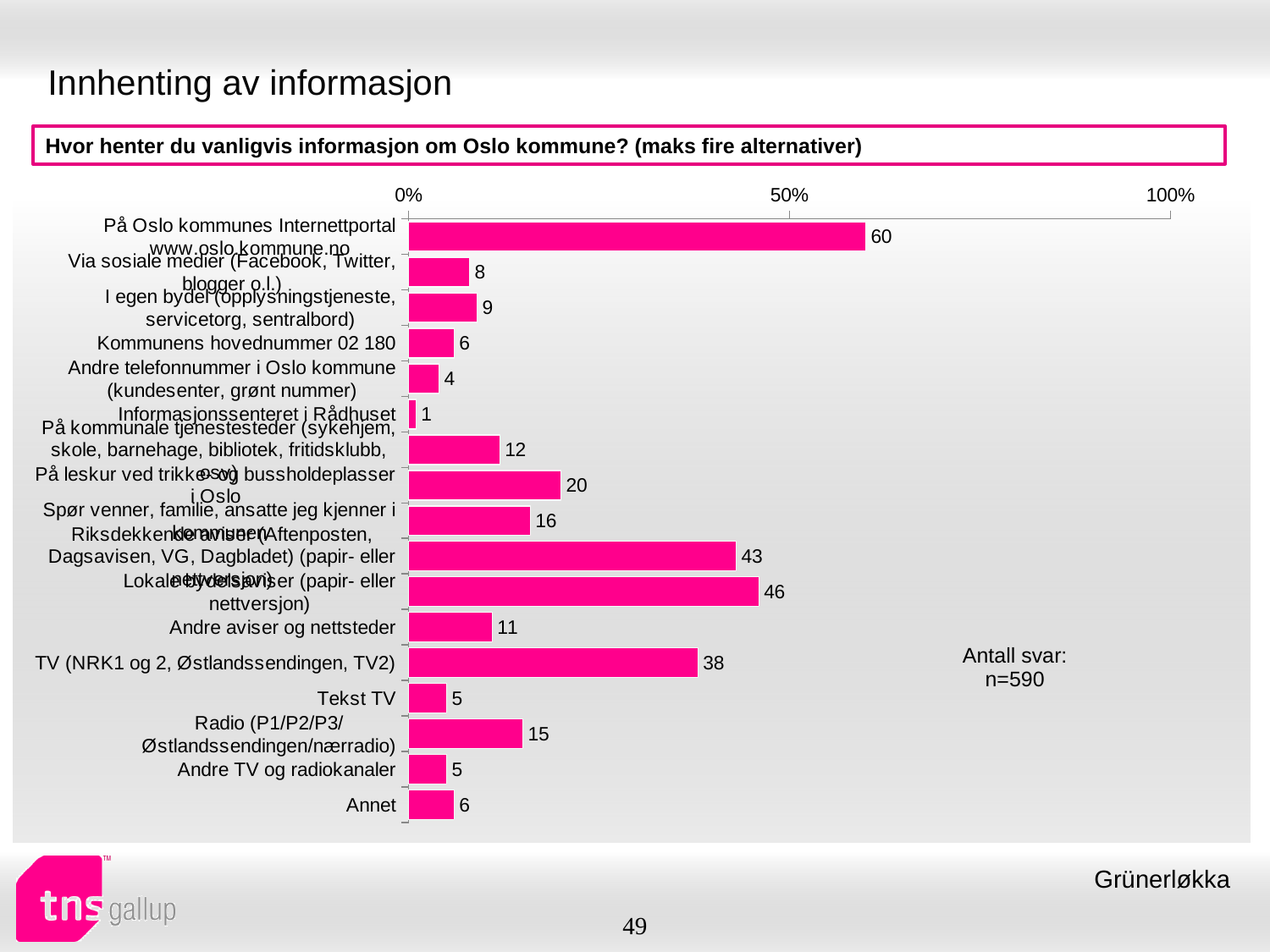
How many categories are shown in the chart? 17 What is the difference between the values for "TV (NRK1 og 2, Østlandssendingen, TV2)" and "Tekst TV"? 33 What is the value for "Radio (P1/P2/P3/ Østlandssendingen/nærradio)"? 15 What is the value for "TV (NRK1 og 2, Østlandssendingen, TV2)"? 38 What is the value for "På Oslo kommunes Internettportal www.oslo.kommune.no"? 60 What is the value for "Andre aviser og nettsteder"? 11 Which is larger, the value for "Andre aviser og nettsteder" or the value for "Annet"? Andre aviser og nettsteder What is the number of respondents (n) stated on the slide? n=590 What is the value for "Kommunens hovednummer 02 180"? 6 Which category has the lowest value? Informasjonssenteret i Rådhuset What kind of chart is shown on the slide? bar chart Which category has the highest value? På Oslo kommunes Internettportal www.oslo.kommune.no